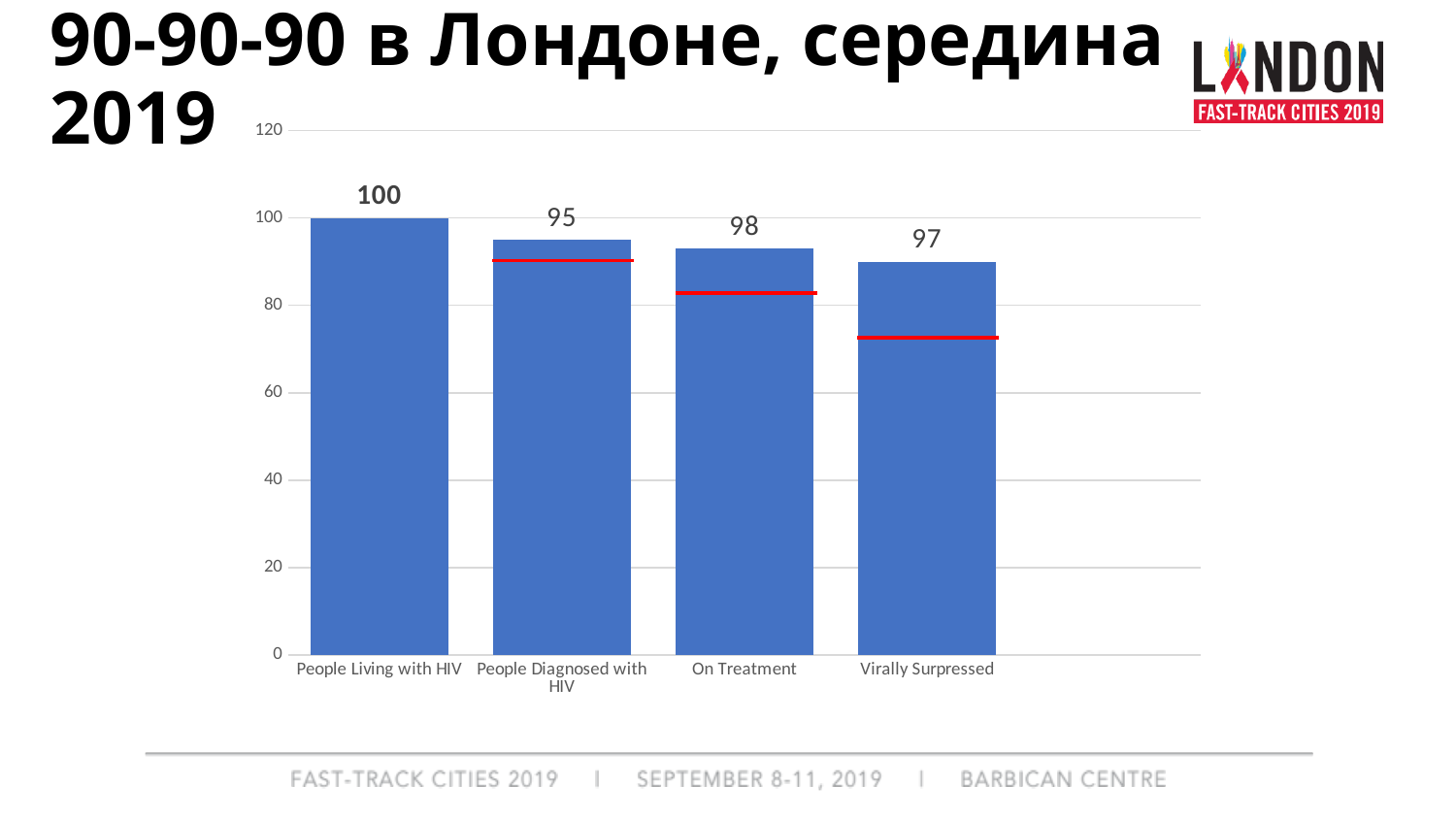
What value is labelled on the bar for People Living with HIV? 100 What value is labelled on the bar for Virally Surpressed? 97 What value is labelled on the bar for On Treatment? 98 What is the title of the slide? 90-90-90 в Лондоне, середина 2019 Which is larger, the bar for People Living with HIV or the bar for Virally Surpressed? People Living with HIV How many categories are shown on the x axis? 4 What kind of chart is shown on the slide? bar chart What value is labelled on the bar for People Diagnosed with HIV? 95 Is the bar for On Treatment greater or less than 60? greater What is the difference between the labelled values for People Living with HIV and People Diagnosed with HIV? 5 Is the bar for Virally Surpressed greater or less than 80? greater Which category has the highest bar? People Living with HIV